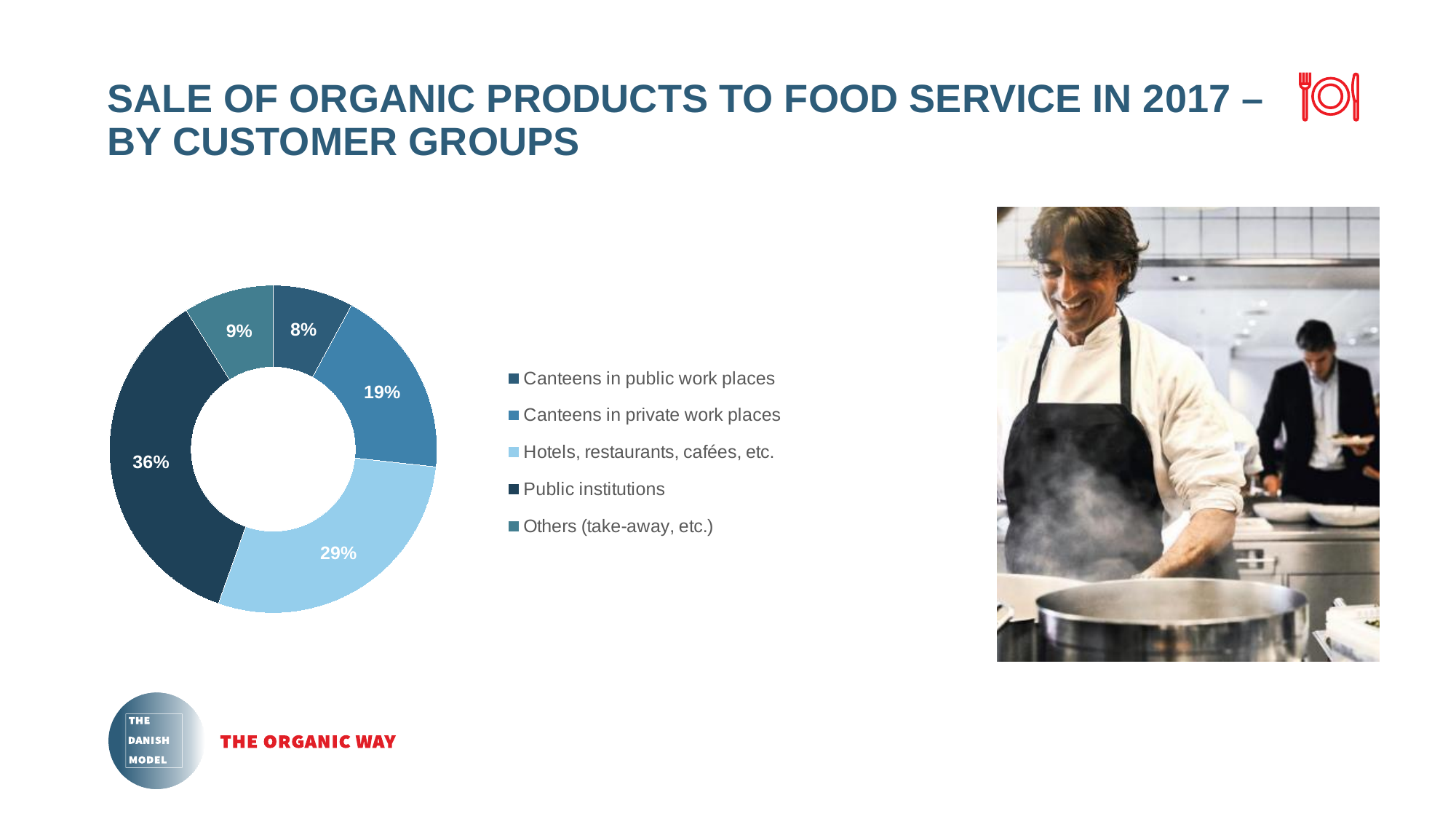
How many percentage points larger is the share for public institutions than for hotels, restaurants, cafées, etc.? 7 Which customer group has the smallest share? Canteens in public work places How many customer groups are shown in the chart? 5 Which customer group has the largest share of organic food service sales? Public institutions What percentage is shown for canteens in public work places? 8% What percentage of sales went to hotels, restaurants, cafées, etc.? 29% What is the combined share of canteens in public and private work places? 27% Which has a larger share: canteens in private work places or others (take-away, etc.)? Canteens in private work places What share of sales went to others (take-away, etc.)? 9% What share of sales went to canteens in private work places? 19% What type of chart is used on this slide? Doughnut chart What share of organic food service sales in 2017 went to public institutions? 36%